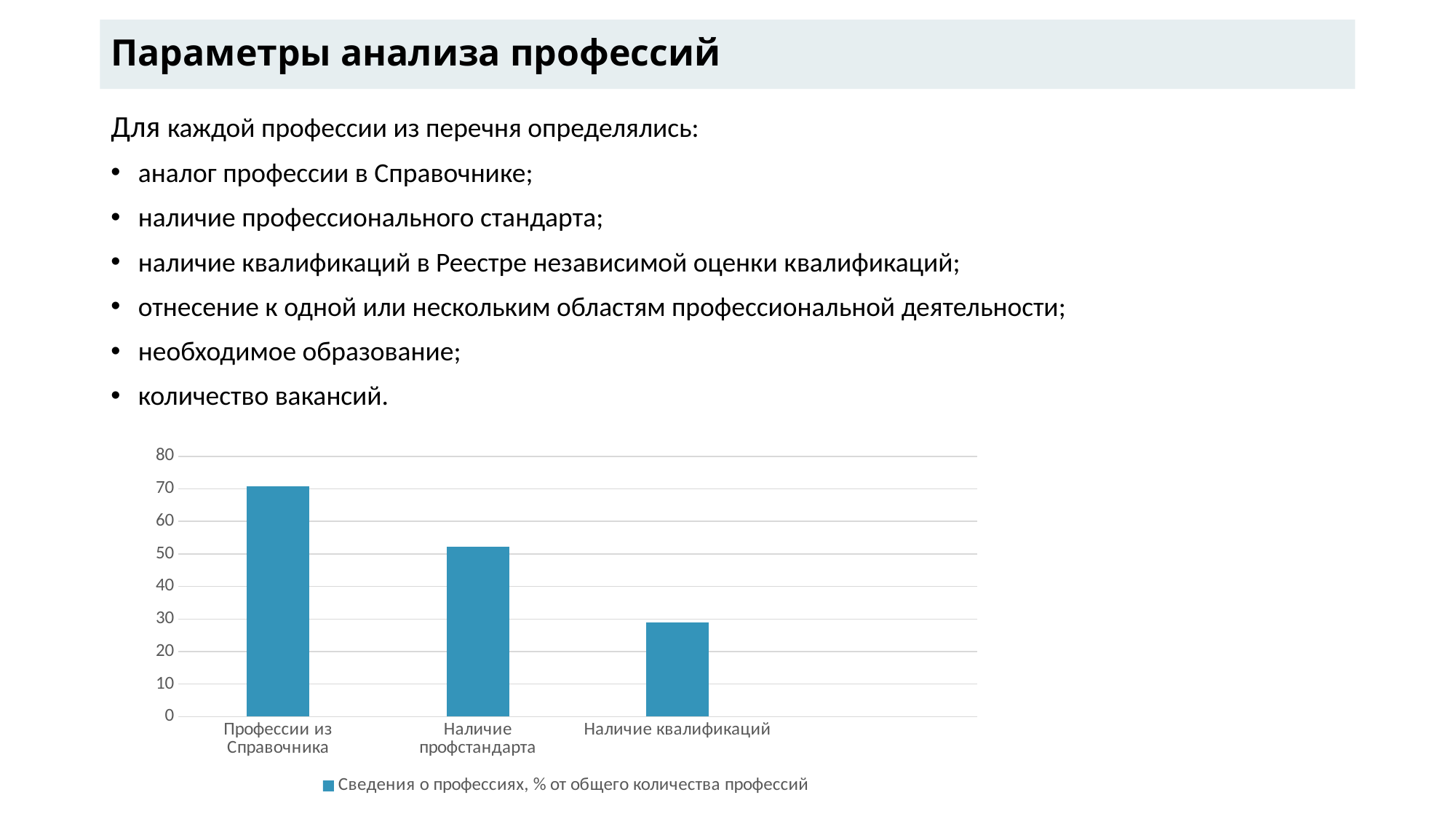
Is the value for Наличие профстандарта greater or less than 60? less Is the value for Наличие квалификаций greater or less than 40? less Do the bar values rise or fall from left to right along the x axis? fall What is the legend entry of the series shown in the chart? Сведения о профессиях, % от общего количества профессий How many series does the chart legend list? 1 How many categories are shown on the x axis of the chart? 3 Which category has the lowest bar in the chart? Наличие квалификаций Which is larger: the value for Наличие профстандарта or the value for Наличие квалификаций? Наличие профстандарта Is the value for Наличие квалификаций greater or less than 20? greater What kind of chart is shown on the slide? bar chart Which category has the highest bar in the chart? Профессии из Справочника